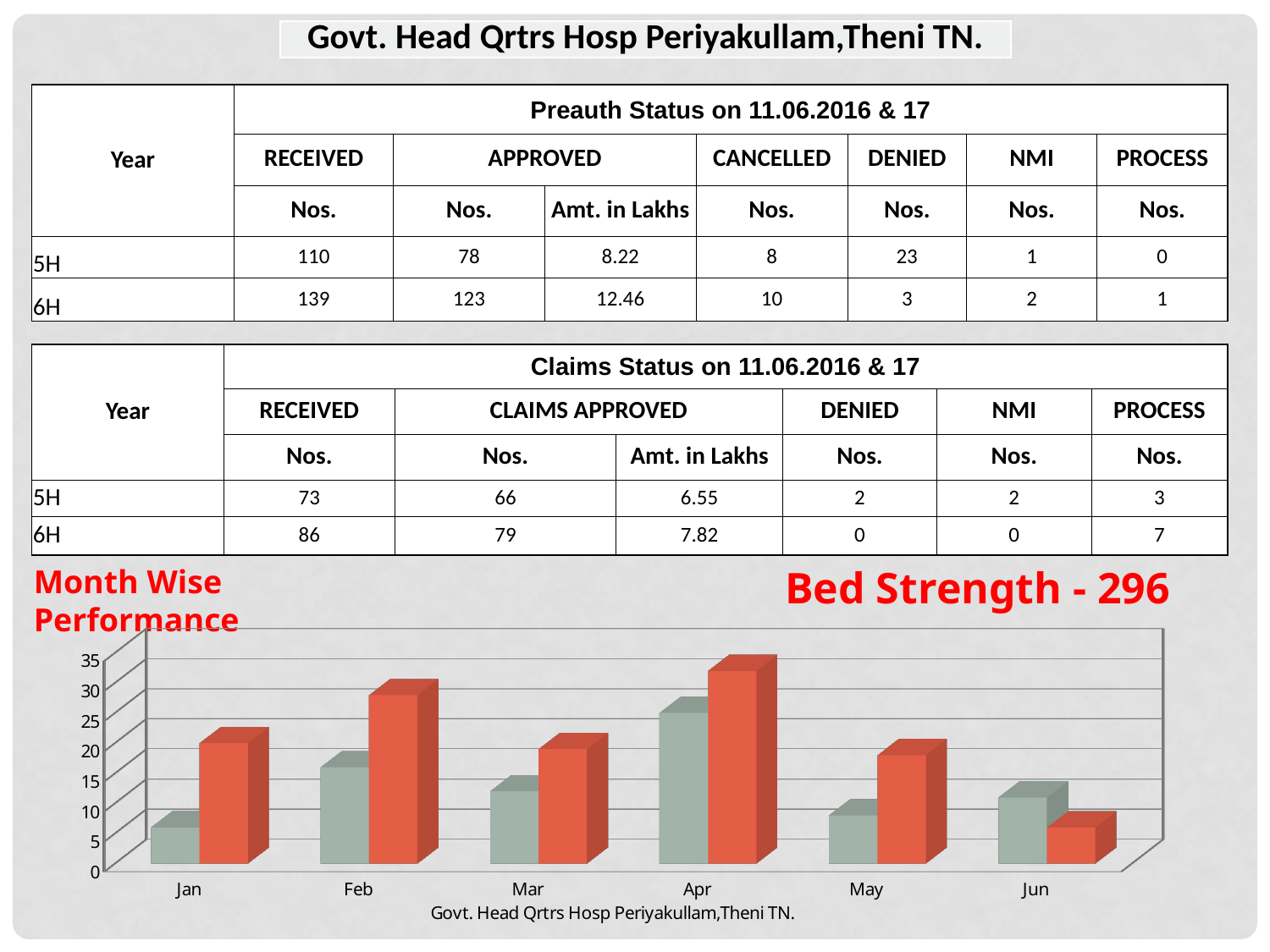
In the bar chart, which month has the shortest grey bar? Jan In the bar chart, is the red bar for Jun greater or less than 10? less What kind of chart is shown at the bottom of the slide? bar chart In the bar chart, for Jun, which bar is taller: the grey bar or the red bar? the grey bar In the bar chart, is the red bar for Feb greater or less than 25? greater In the bar chart, which month has the shortest red bar? Jun How many months are shown on the x axis of the bar chart? 6 In the bar chart, is the grey bar for Apr greater or less than 20? greater In the bar chart, which month has the tallest grey bar? Apr What text appears below the x axis of the bar chart? Govt. Head Qrtrs Hosp Periyakullam,Theni TN. In the bar chart, which month has the tallest red bar? Apr